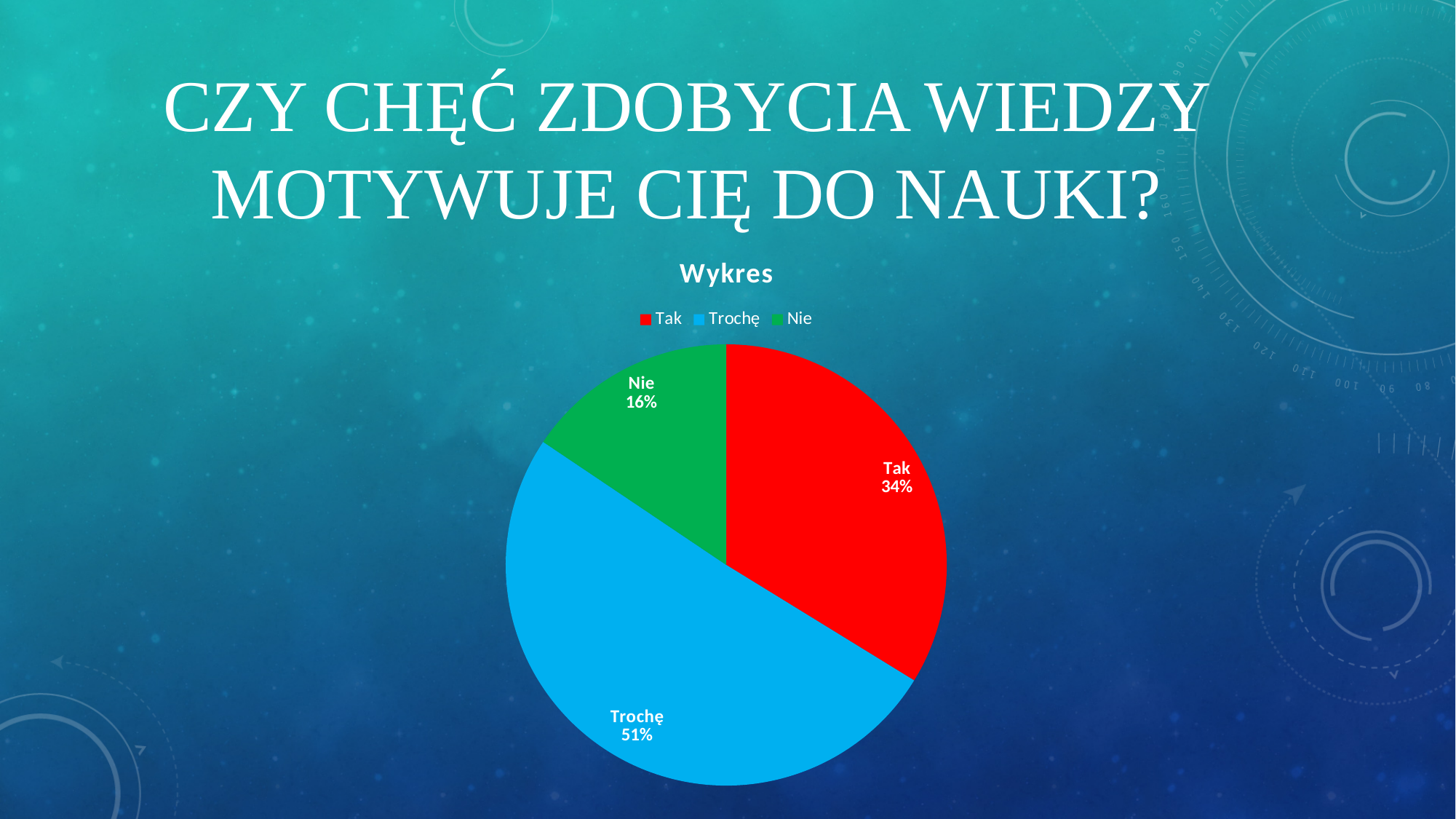
What colour is the "Trochę" slice? blue Which slice is larger, "Tak" or "Nie"? Tak What share of the pie does the "Tak" slice represent? 34% What share of the pie does the "Nie" slice represent? 16% What is the difference in percentage points between the "Trochę" and "Tak" slices? 17 What is the difference in percentage points between the "Tak" and "Nie" slices? 18 Which category has the smallest slice of the pie? Nie What type of chart is shown on the slide? pie chart How many categories does the pie chart have? 3 Which category has the largest slice of the pie? Trochę What is the title of the chart? Wykres What share of the pie does the "Trochę" slice represent? 51%